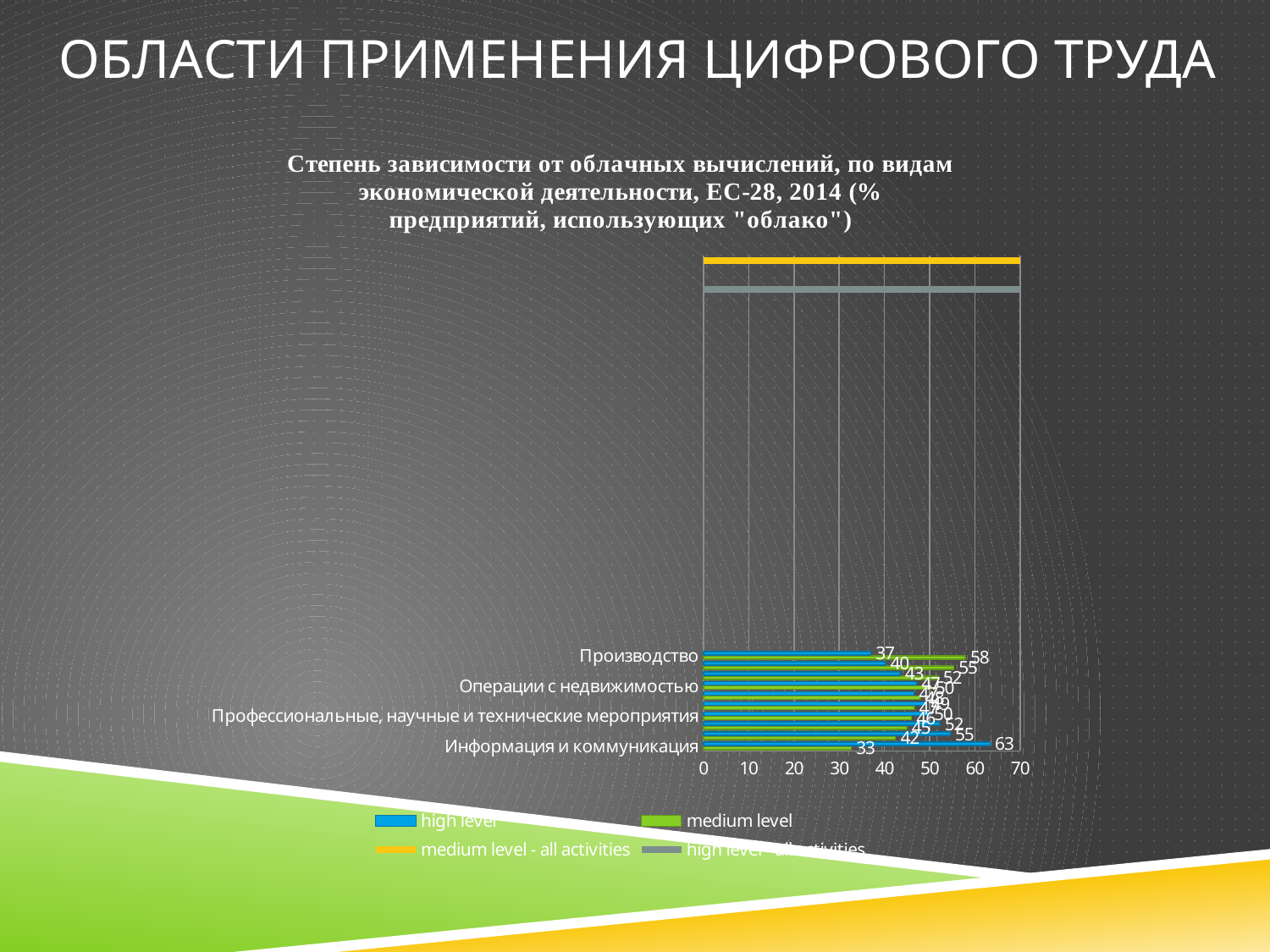
What is the medium level value for Производство? 58 What is the difference between the medium level and high level values for Производство? 21 Is the high level value for Информация и коммуникация greater or less than 60? greater What is the high level value for Производство? 37 What is the medium level value for Информация и коммуникация? 33 For Производство, which is larger: the high level value or the medium level value? medium level What kind of chart is shown on the slide? bar chart What is the high level value for Информация и коммуникация? 63 How many series does the chart legend list? 4 What is the difference between the high level and medium level values for Информация и коммуникация? 30 Which labelled category has the highest high level value? Информация и коммуникация What is the maximum value shown on the horizontal axis? 70